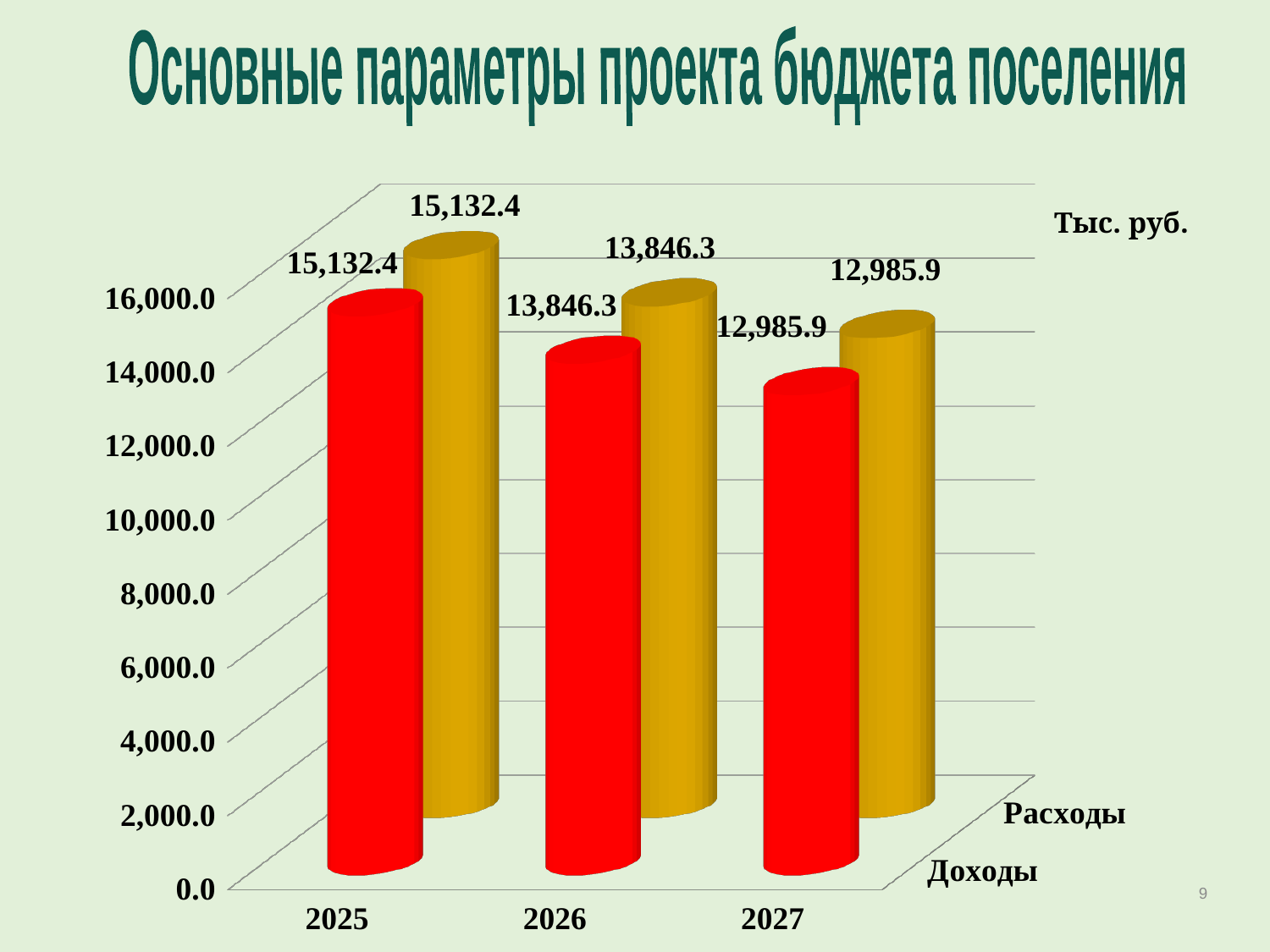
What is the value for Доходы in 2025? 15,132.4 What is the value for Расходы in 2026? 13,846.3 Do the Доходы values rise or fall from 2025 to 2027? fall Which year has the highest value for Доходы? 2025 What is the difference between the Доходы values for 2025 and 2026? 1,286.1 What is the value for Расходы in 2027? 12,985.9 How many years are shown on the x axis? 3 What is the value for Доходы in 2027? 12,985.9 How many series does the chart show? 2 Which year has the lowest value for Расходы? 2027 What is the difference between the Расходы values for 2026 and 2027? 860.4 Is the value for Доходы in 2026 greater or less than 14,000.0? less